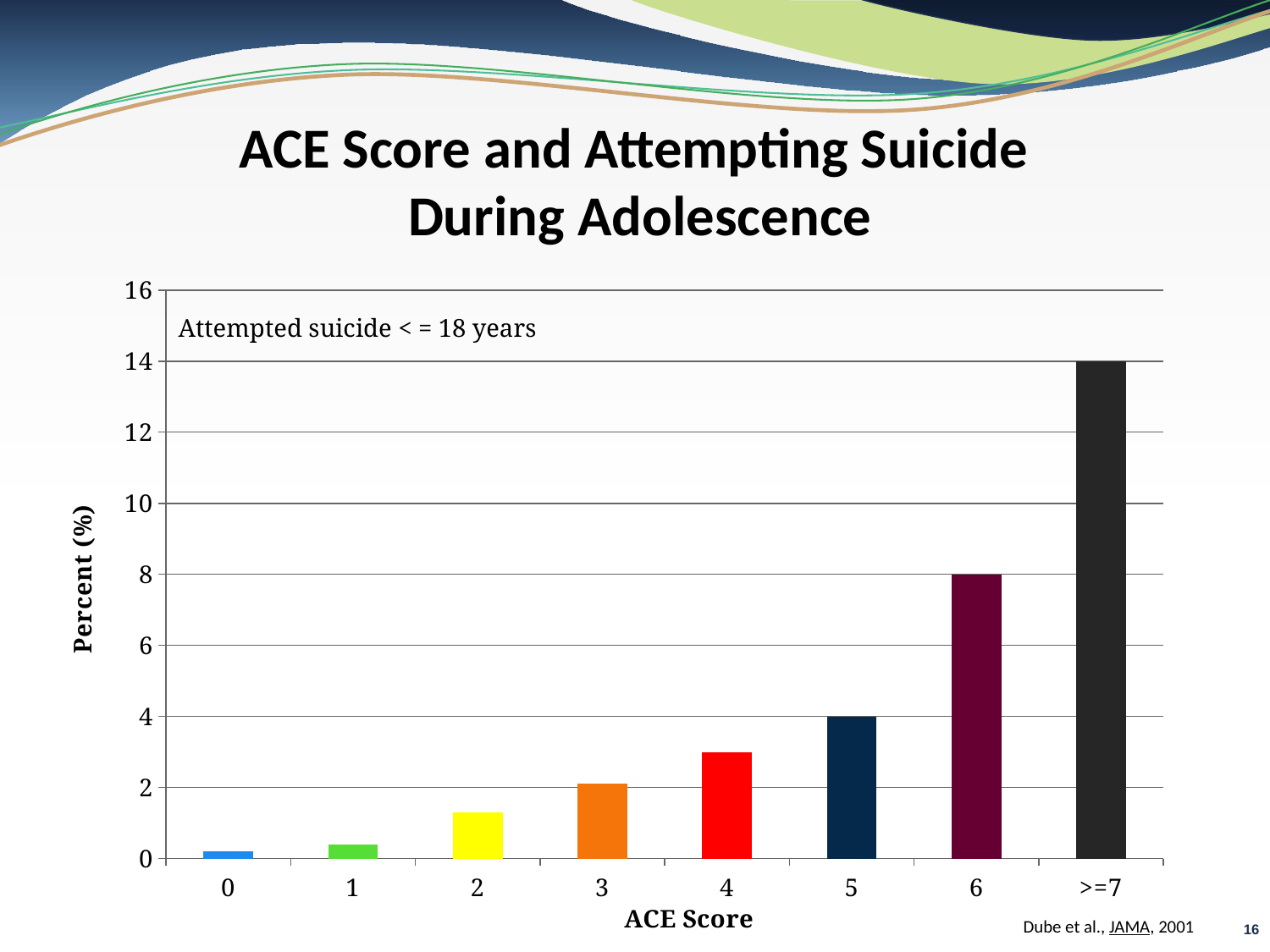
What kind of chart is shown on the slide? bar chart Which ACE Score category has the lowest percent? 0 What is the percent for an ACE Score of 5? 4 How many ACE Score categories are shown on the x axis? 8 Which ACE Score category has the highest percent? >=7 Is the value for ACE Score 4 greater or less than 2? greater What is the difference in percent between ACE Score >=7 and ACE Score 6? 6 Do the values rise or fall as the ACE Score increases along the x axis? rise Is the value for ACE Score 2 greater or less than 2? less What is the percent for an ACE Score of >=7? 14 What is the percent for an ACE Score of 6? 8 Which is larger, the percent for ACE Score 3 or ACE Score 5? ACE Score 5